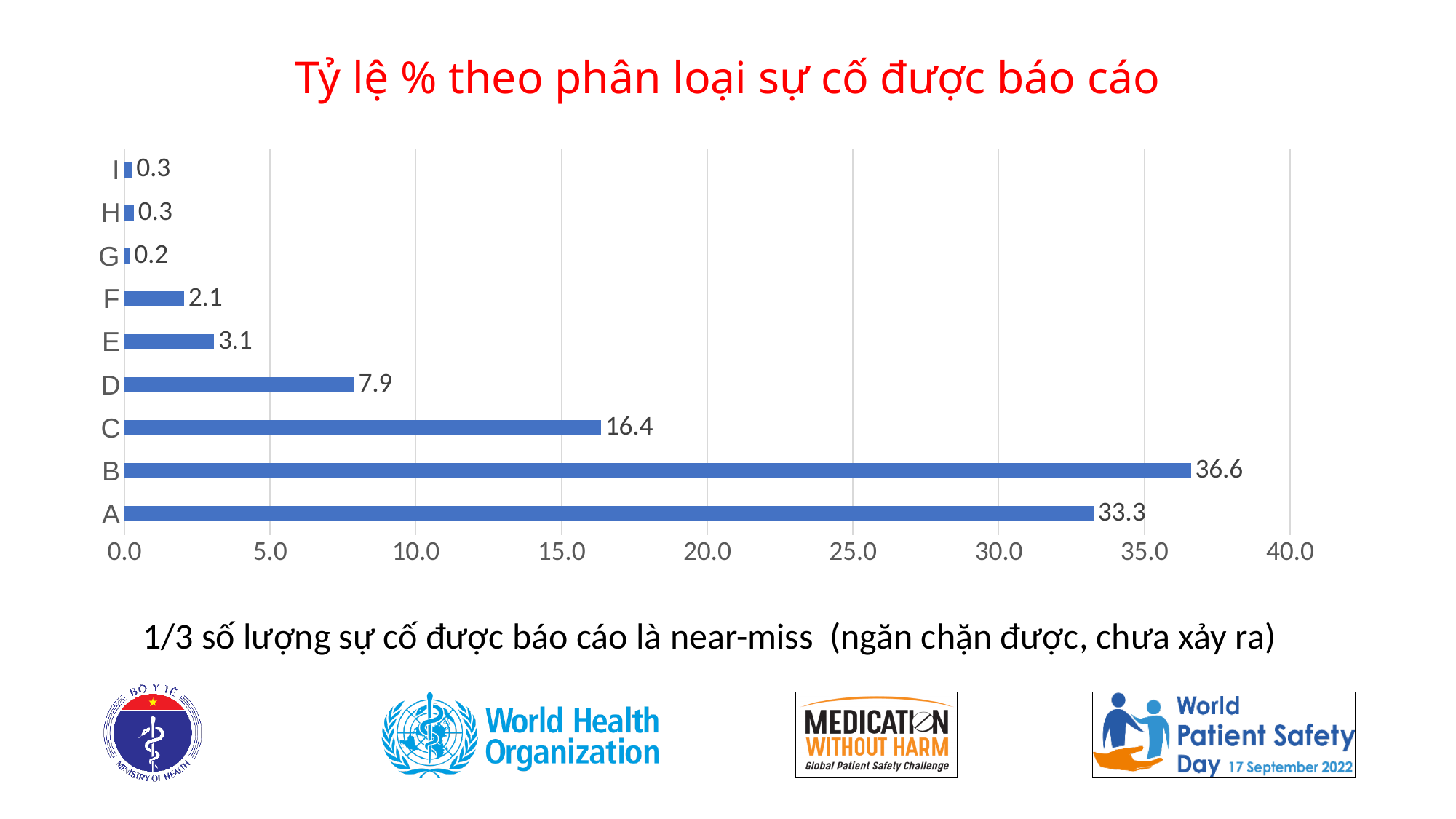
How many categories are shown in the chart? 9 What is the difference between the values for C and D? 8.5 What is the title of the chart? Tỷ lệ % theo phân loại sự cố được báo cáo Which is larger, the value for E or the value for F? E Which category has the lowest value? G Is the value for A greater or less than 30.0? greater What is the value for category F? 2.1 What kind of chart is shown on the slide? Bar chart What is the difference between the values for B and A? 3.3 What is the value for category D? 7.9 Which category has the highest value? B What is the value for category B? 36.6